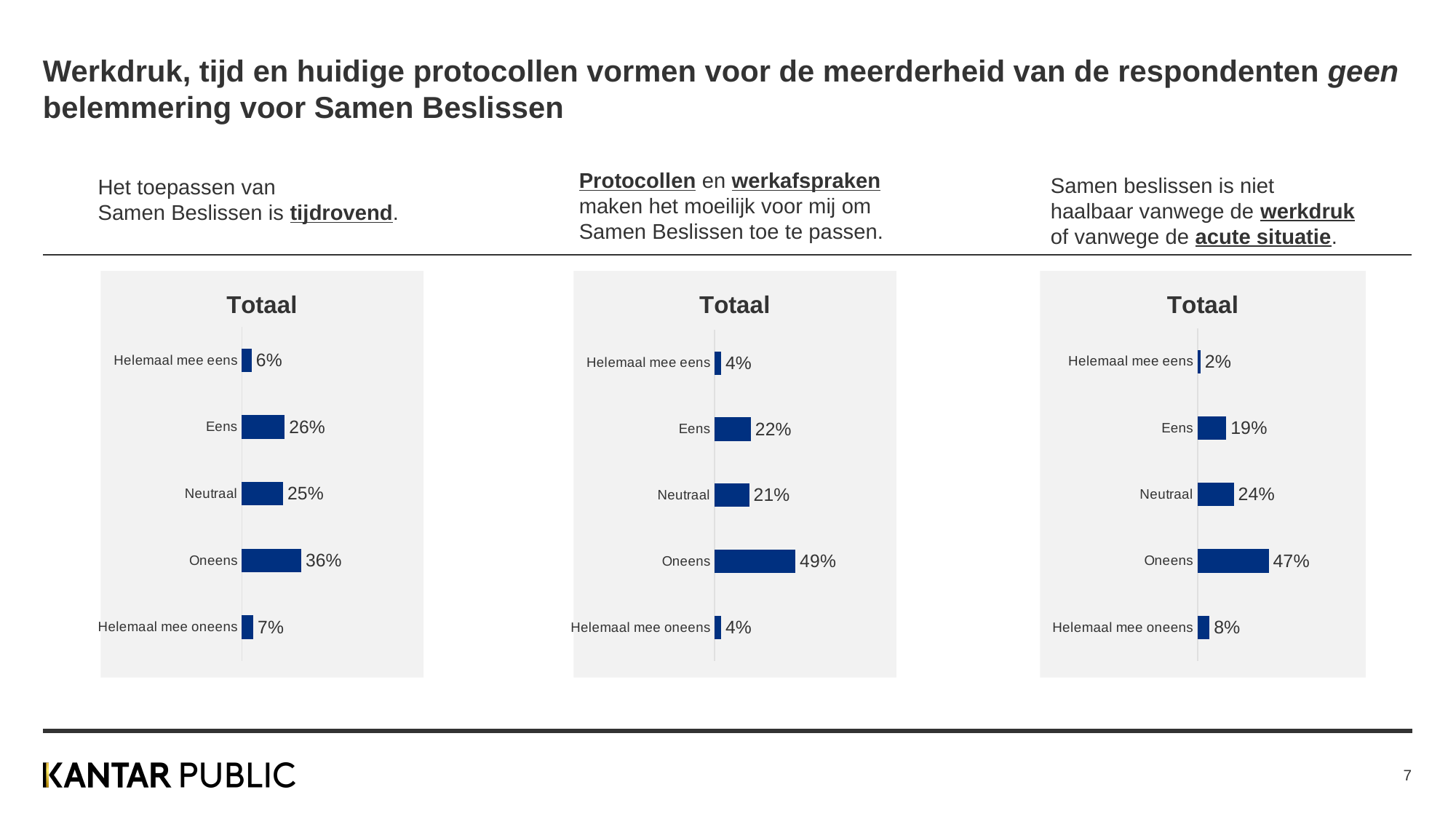
In the right chart (werkdruk / acute situatie), what is the combined percentage of Oneens and Helemaal mee oneens? 55% What is the title shown above each of the three charts? Totaal In the middle chart (Protocollen en werkafspraken), what percentage of respondents answered Oneens? 49% In the middle chart (Protocollen en werkafspraken), what is the difference in percentage points between Oneens and Eens? 27 In the right chart (werkdruk / acute situatie), which is larger: the percentage for Neutraal or for Eens? Neutraal In the left chart (Het toepassen van Samen Beslissen is tijdrovend), which response category has the lowest percentage? Helemaal mee eens What type of chart is used in the middle chart (Protocollen en werkafspraken)? Bar chart In the right chart (werkdruk / acute situatie), what percentage of respondents answered Helemaal mee eens? 2% In the left chart (Het toepassen van Samen Beslissen is tijdrovend), what is the combined percentage of Helemaal mee eens and Eens? 32% In the left chart (Het toepassen van Samen Beslissen is tijdrovend), what percentage of respondents answered Oneens? 36% How many response categories are shown in the left chart? 5 In the right chart (werkdruk / acute situatie), which response category has the highest percentage? Oneens